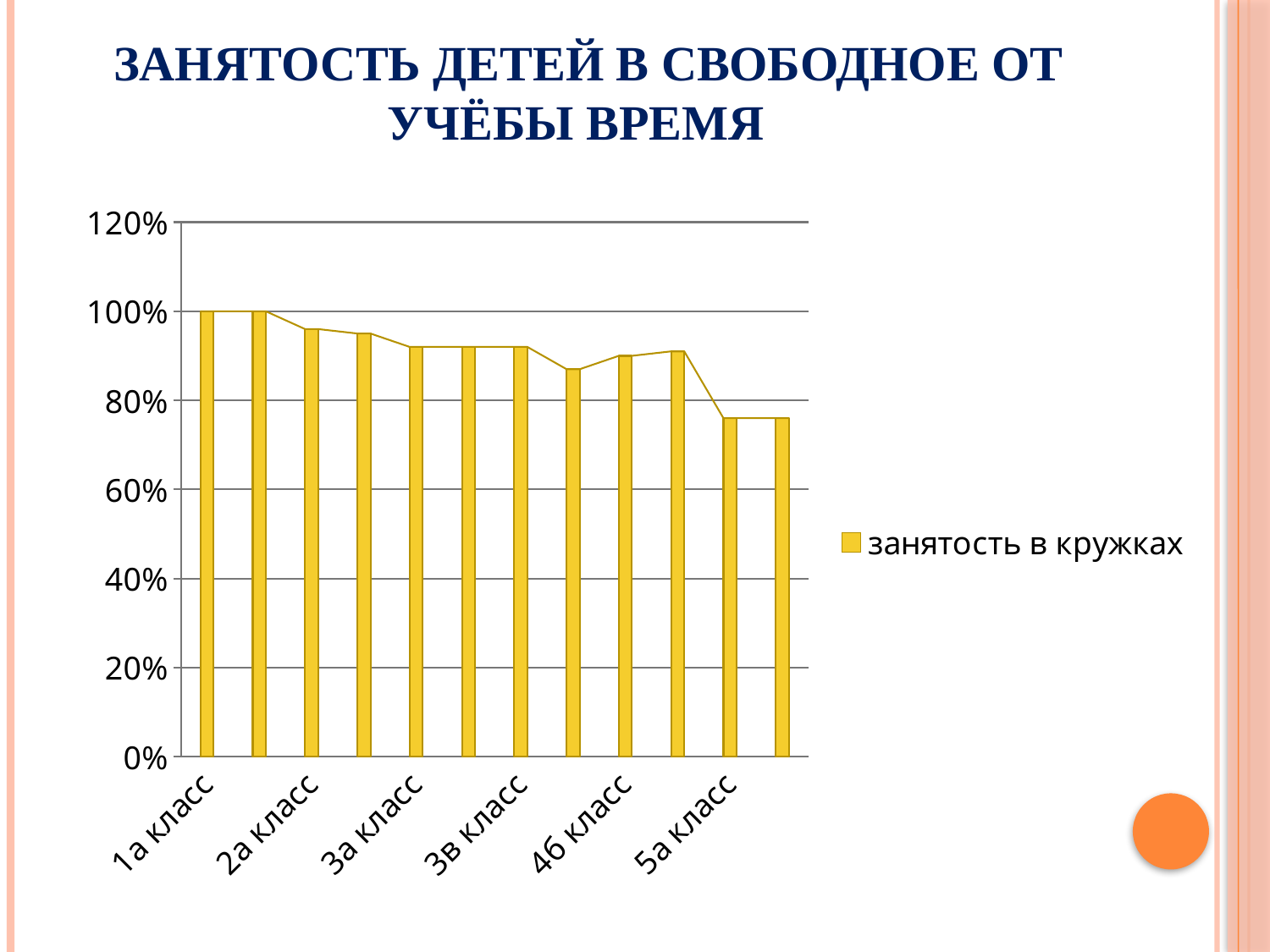
Which is larger, the value for 1а класс or the value for 5а класс? 1а класс What kind of chart is shown on the slide? bar chart Is the value for 2а класс greater or less than 80%? greater Is the value for 4б класс greater or less than 80%? greater What is the legend entry for the series in the chart? занятость в кружках What is the value for 1а класс? 100% How many bars are plotted in the chart? 12 Is the value for 3а класс greater or less than 100%? less How many series does the legend list? 1 What is the title of the slide containing the chart? ЗАНЯТОСТЬ ДЕТЕЙ В СВОБОДНОЕ ОТ УЧЁБЫ ВРЕМЯ Do the values generally rise or fall from left to right along the x axis? fall